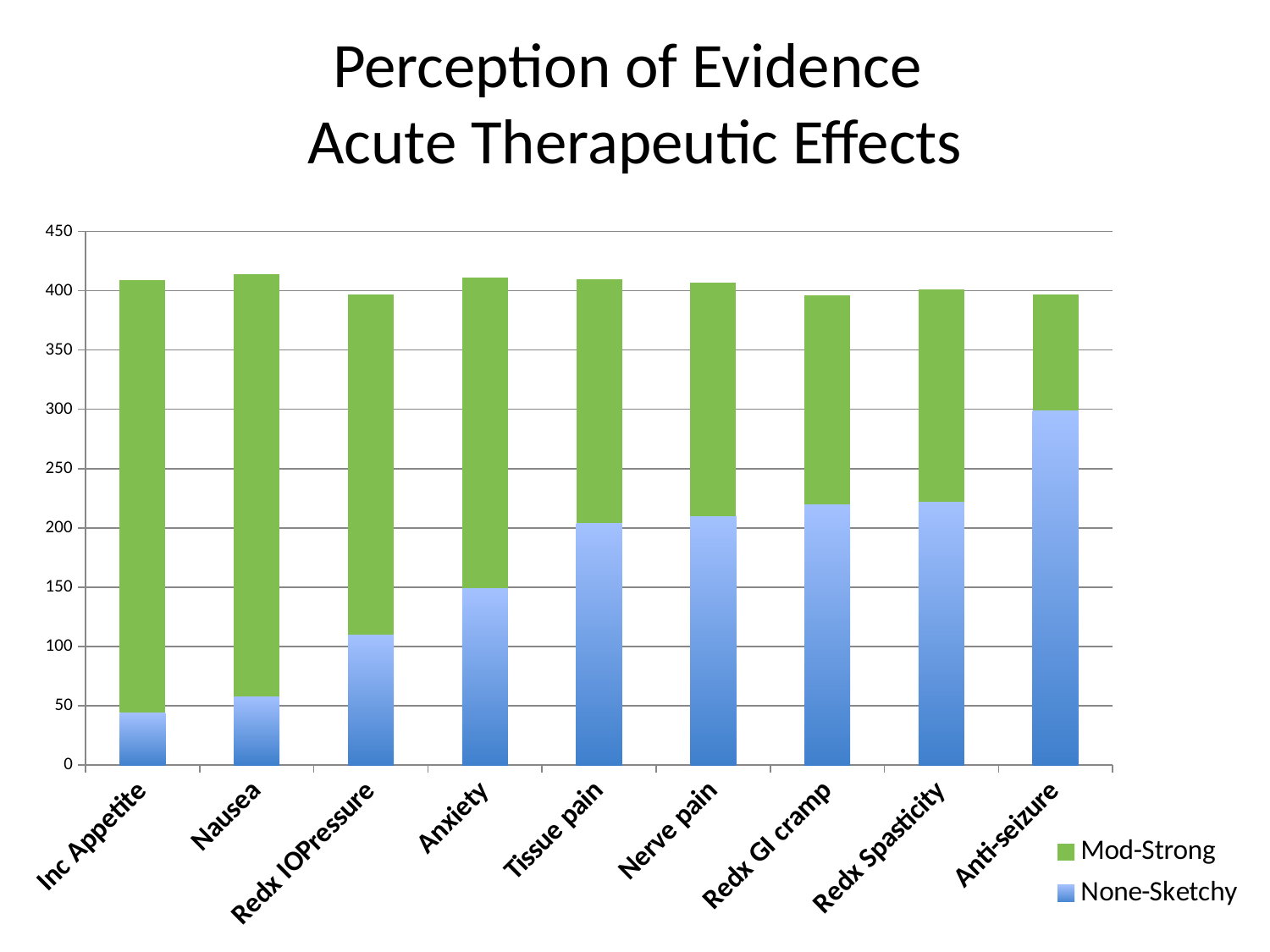
Which has the larger Mod-Strong segment, Inc Appetite or Anti-seizure? Inc Appetite What kind of chart is shown on the slide? Stacked bar chart Which category has the lowest None-Sketchy value? Inc Appetite What is the title of the chart? Perception of Evidence Acute Therapeutic Effects How many categories are shown on the x axis? 9 What are the two series named in the legend? Mod-Strong and None-Sketchy Do the None-Sketchy values rise or fall moving left to right along the x axis? Rise Is the None-Sketchy value for Anti-seizure greater or less than 250? greater Which category has the highest None-Sketchy value? Anti-seizure Is the total stacked value for Nausea greater or less than 450? less How many series does the legend list? 2 Is the None-Sketchy value for Inc Appetite greater or less than 50? less